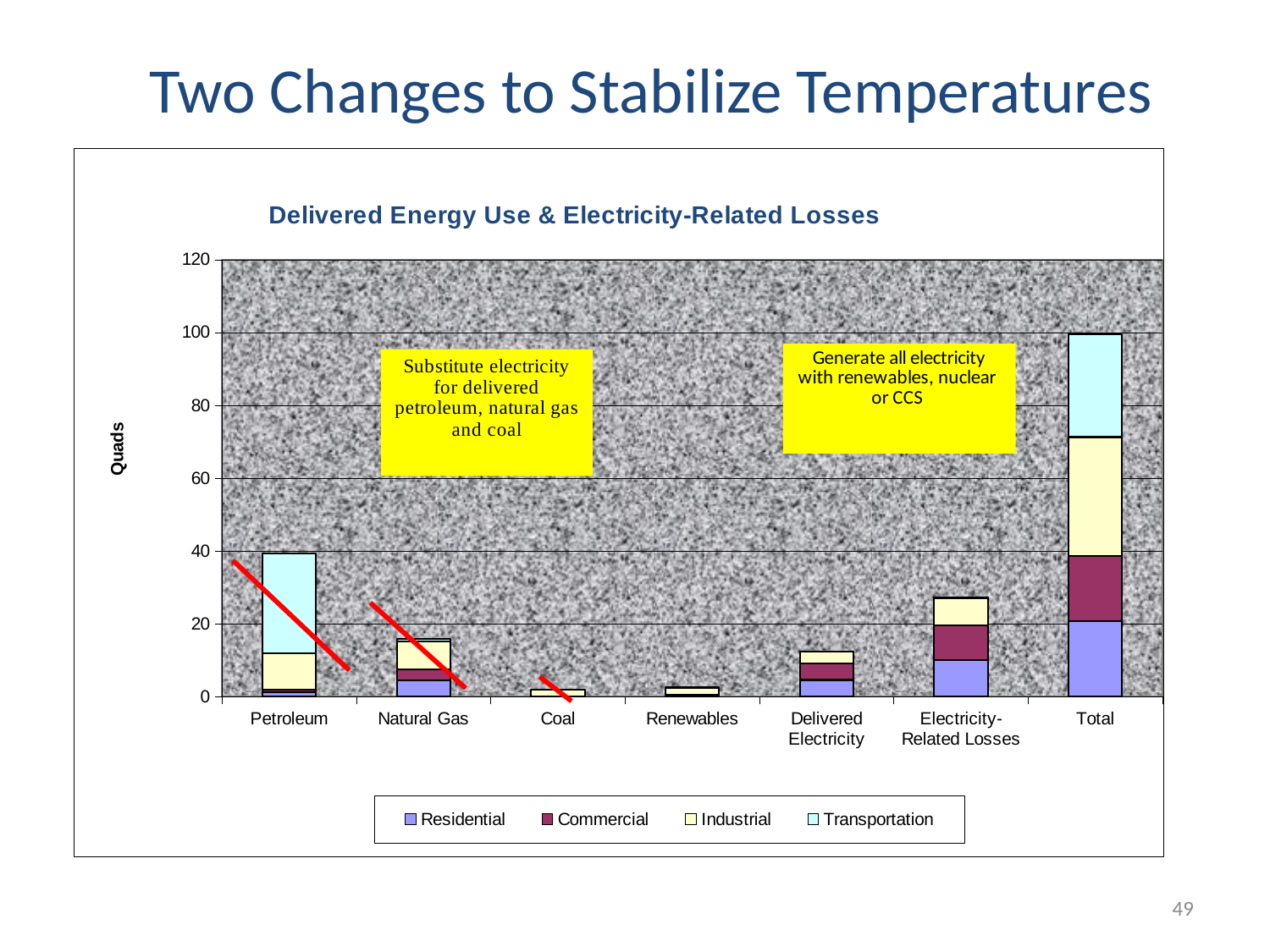
Which category has the tallest stacked bar? Total What is the label on the vertical axis of the chart? Quads What kind of chart is shown on the slide? stacked bar chart Which has the larger stacked bar, Delivered Electricity or Electricity-Related Losses? Electricity-Related Losses Is the total value for Natural Gas greater or less than 20? less How many series does the legend list? 4 Which has the larger stacked bar, Petroleum or Natural Gas? Petroleum Is the total value for Petroleum greater or less than 20? greater Is the total value for Electricity-Related Losses greater or less than 20? greater How many categories are shown along the x axis? 7 What is the title of the chart? Delivered Energy Use & Electricity-Related Losses